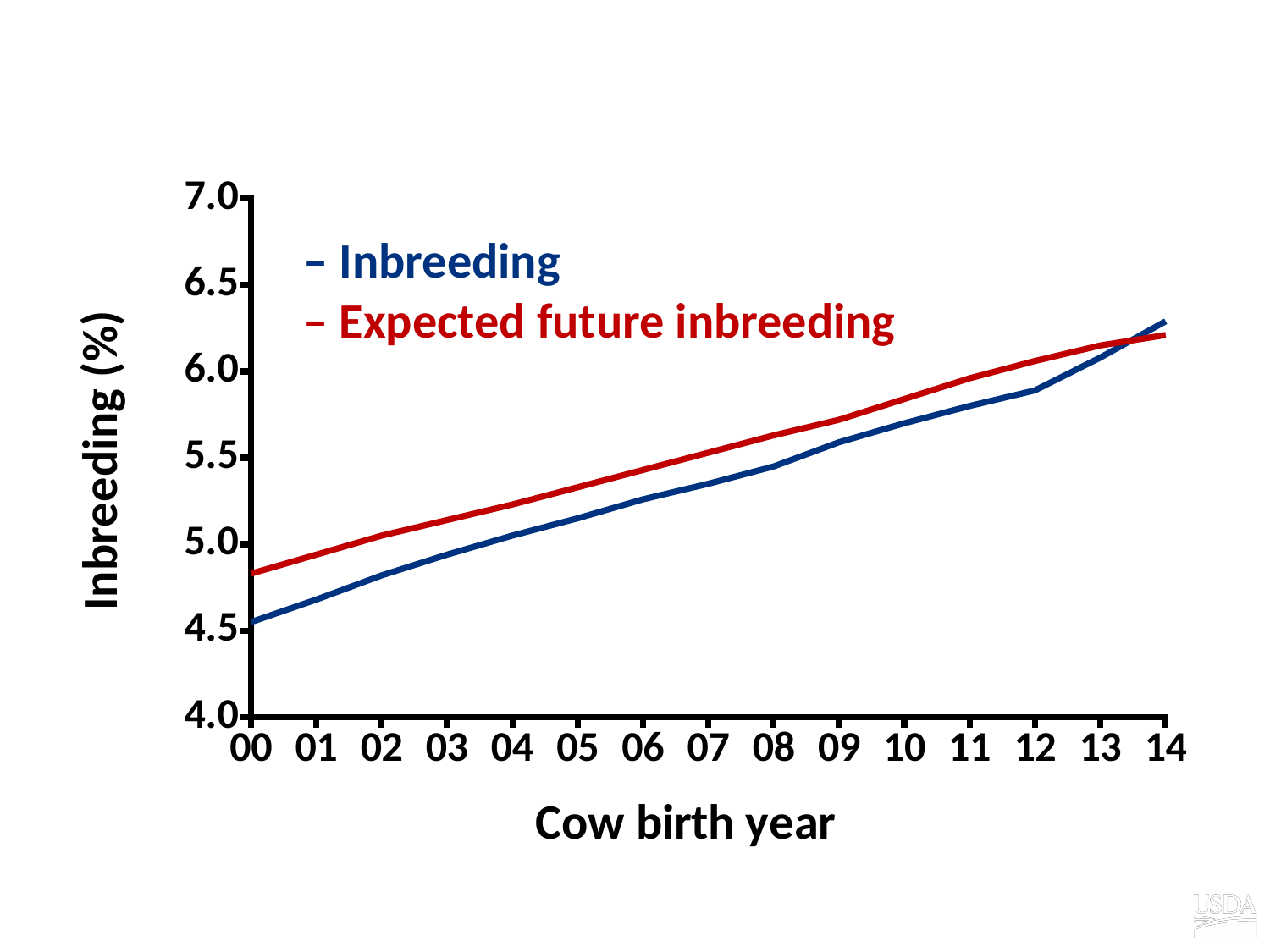
What is the title of the x axis? Cow birth year Is the Inbreeding value for birth year 12 greater or less than 6.0? less Is the Expected future inbreeding value for birth year 14 greater or less than 6.0? greater Does the Expected future inbreeding line rise or fall across the birth years? rise At birth year 00, which series has the higher value, Inbreeding or Expected future inbreeding? Expected future inbreeding Is the Inbreeding value for birth year 00 greater or less than 5.0? less What kind of chart is shown on the slide? line chart How many series does the legend list? 2 Does the Inbreeding line rise or fall from birth year 00 to 14? rise At birth year 06, which series has the higher value, Inbreeding or Expected future inbreeding? Expected future inbreeding How many cow birth years are shown along the x axis? 15